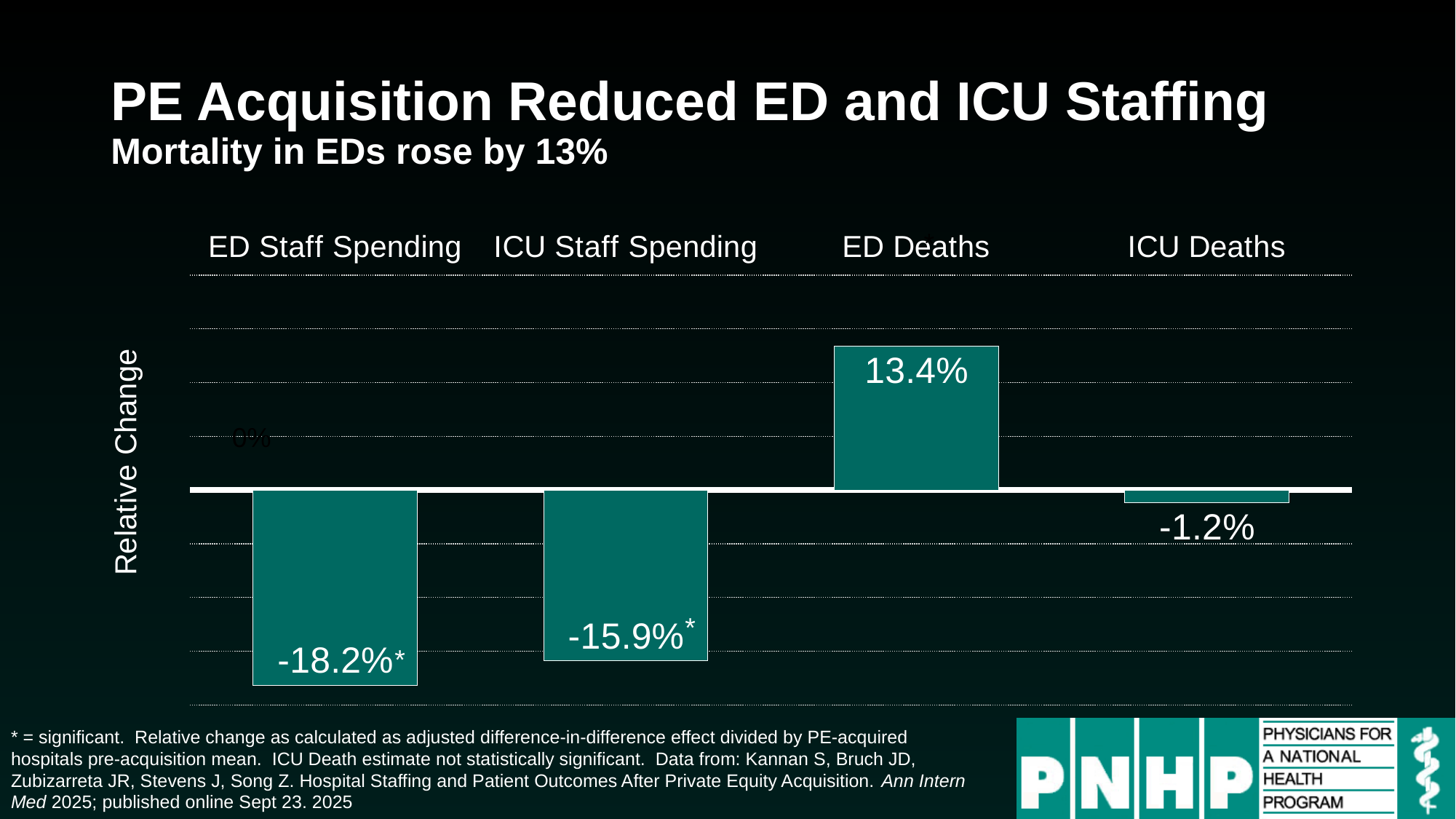
Which category has the lowest relative change? ED Staff Spending What kind of chart is shown on the slide? Bar chart What is the label on the vertical axis of the chart? Relative Change What is the relative change shown for ED Deaths? 13.4% What is the difference between the relative change for ED Staff Spending and ICU Staff Spending? 2.3 percentage points What is the relative change shown for ICU Deaths? -1.2% Which category has the highest relative change? ED Deaths Which category is the only one with a positive relative change? ED Deaths What is the relative change shown for ED Staff Spending? -18.2% Which is larger, the relative change for ED Deaths or for ICU Deaths? ED Deaths What is the relative change shown for ICU Staff Spending? -15.9% How many categories are shown in the chart? 4